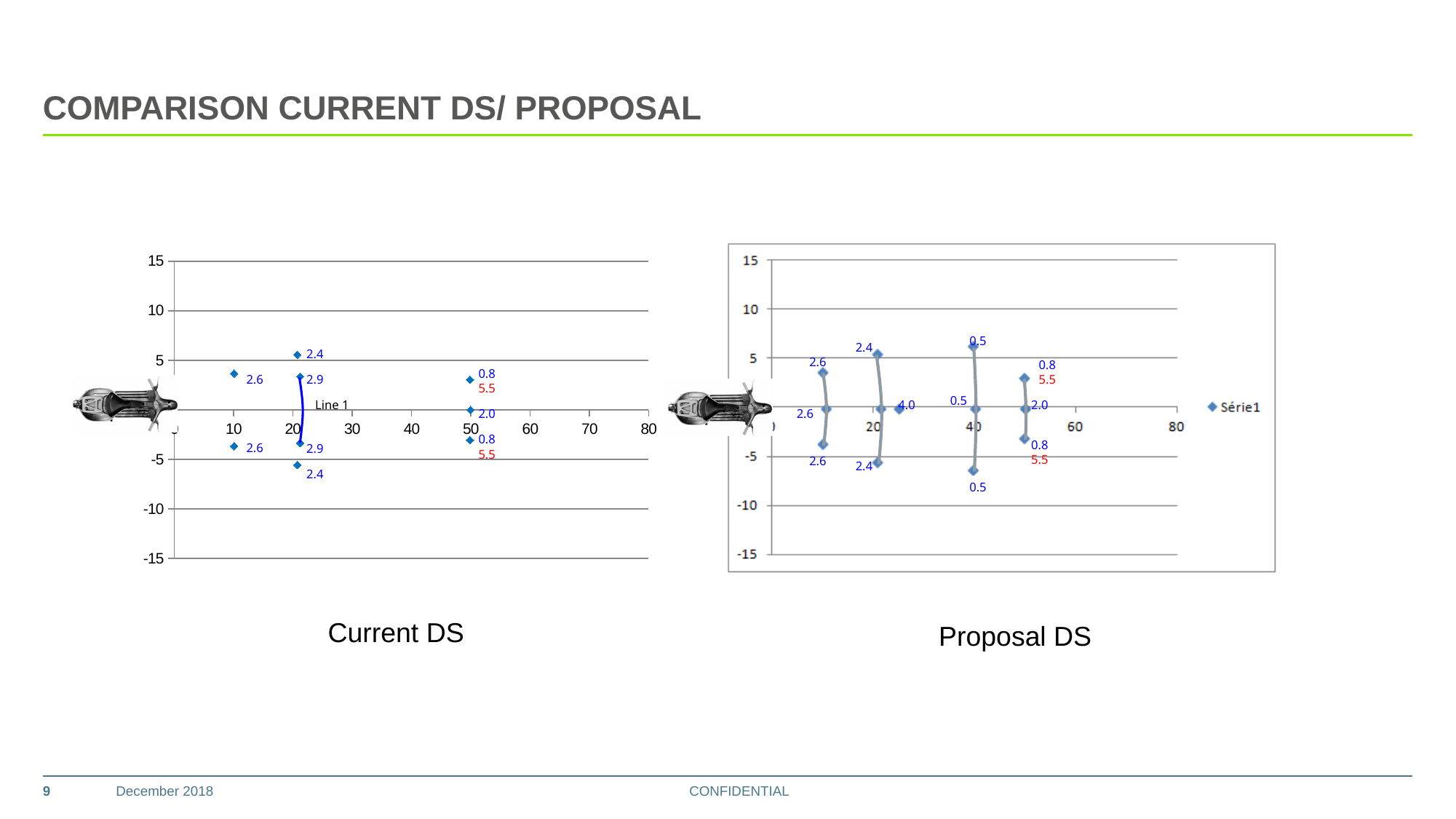
In the Current DS chart, is the value of the upper point at x = 10 greater or less than 5? less Which chart has more plotted points, Current DS or Proposal DS? Proposal DS What is the name of the series shown in the legend of the Proposal DS chart? Série1 What kind of chart is the Proposal DS chart? scatter chart What label is attached to the curved line in the Current DS chart? Line 1 How many series does the legend of the Proposal DS chart list? 1 What kind of chart is the Current DS chart? scatter chart In the Current DS chart, is the value of the upper point at x = 50 greater or less than 5? less In the Proposal DS chart, is the value of the highest point at x = 40 greater or less than 5? greater